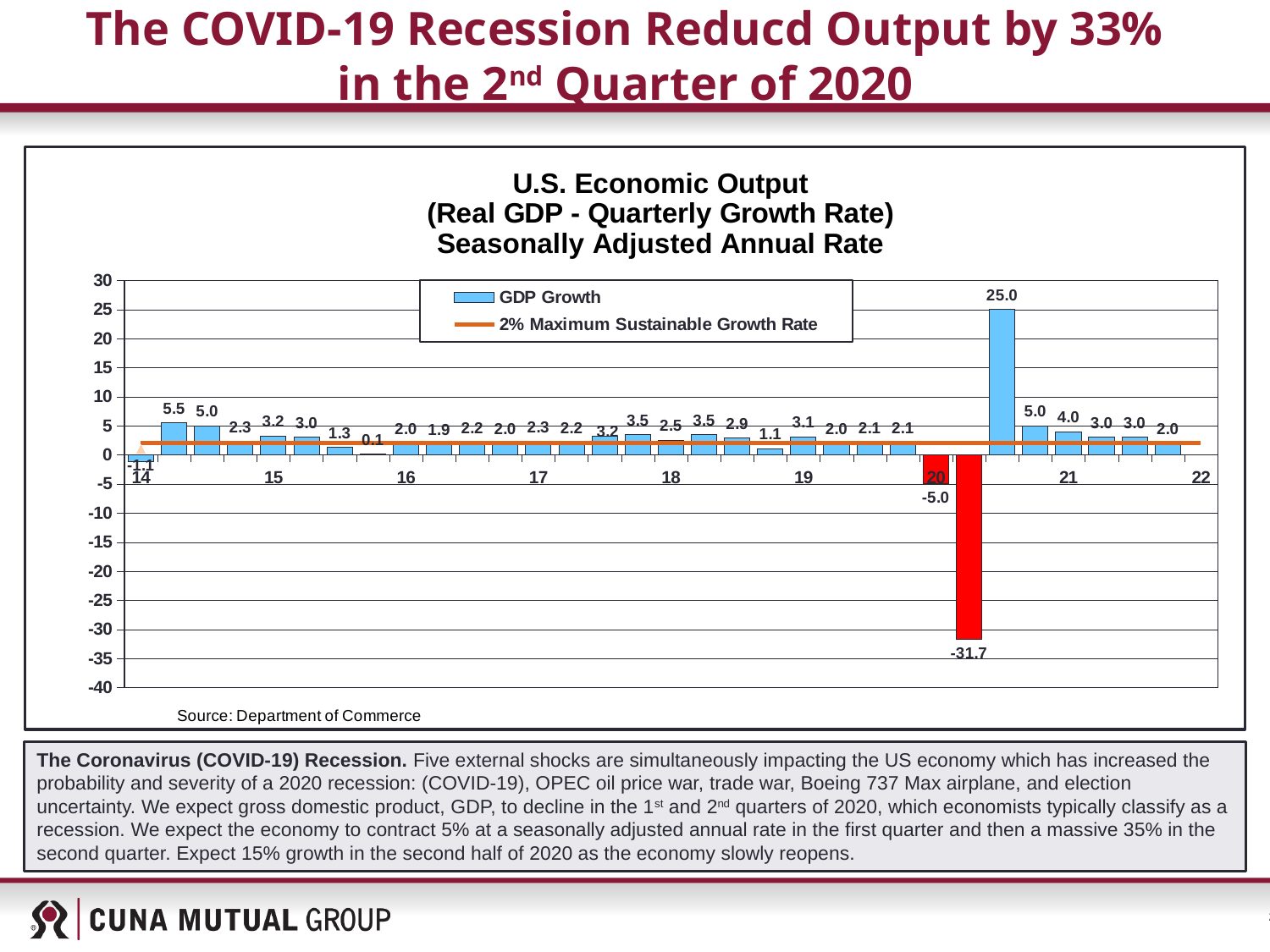
Is the GDP Growth value for the tallest bar greater or less than 20? greater What is the source cited for the chart? Department of Commerce Which is larger, the GDP Growth bar labeled 5.5 or the bar labeled 0.1? 5.5 What is the title of the chart? U.S. Economic Output (Real GDP - Quarterly Growth Rate) Seasonally Adjusted Annual Rate What kind of chart is used to show GDP Growth? Bar chart What is the highest GDP Growth value shown on the chart? 25.0 What is the GDP Growth value of the first bar in 2014? -1.1 What is the GDP Growth value of the last bar on the chart? 2.0 What is the GDP Growth value of the first red bar in 2020? -5.0 What is the lowest GDP Growth value shown on the chart? -31.7 How many series does the legend list? 2 What is the difference between the highest bar (25.0) and the lowest bar (-31.7)? 56.7